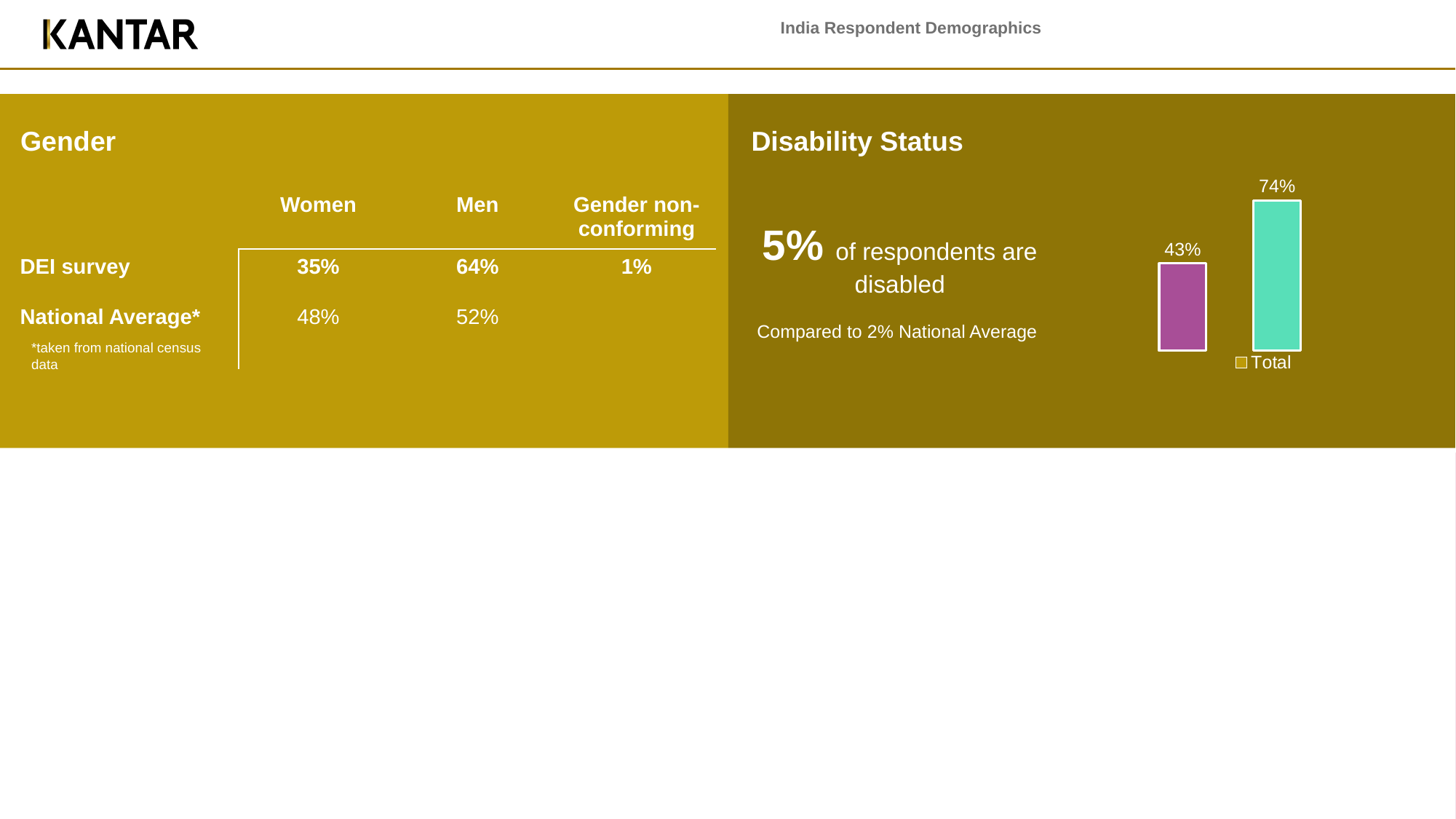
How many bars are plotted in the Disability Status chart? 2 What is the lowest value labelled on the Disability Status chart? 43% What is the value shown on the purple (left) bar in the Disability Status chart? 43% In the Disability Status chart, which bar is taller, the purple one or the teal one? the teal one In the Disability Status chart, what is the difference between the teal bar's value and the purple bar's value? 31% What is the only entry in the legend of the Disability Status chart? Total What colour is the bar labelled 43% in the Disability Status chart? purple What kind of chart is shown in the Disability Status section? bar chart What is the value shown on the teal (right) bar in the Disability Status chart? 74% How many series does the legend of the Disability Status chart list? 1 What is the highest value labelled on the Disability Status chart? 74%